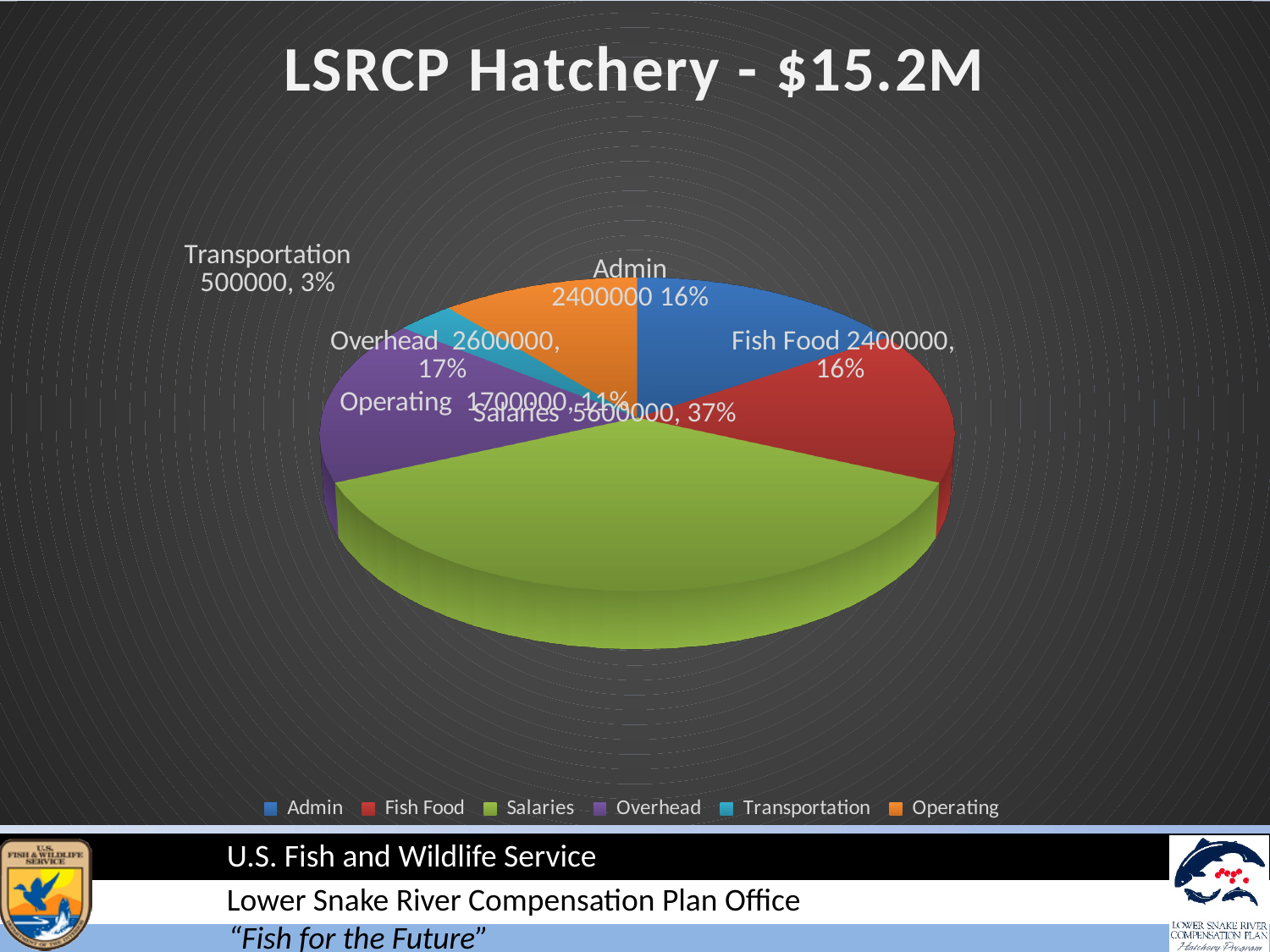
What is the value shown for Transportation? 500000 What percentage share of the pie is Overhead? 17% What percentage share of the pie is Operating? 11% What is the title of the chart? LSRCP Hatchery - $15.2M What is the value shown for Salaries? 5600000 Which category has the largest slice of the pie? Salaries How many entries does the legend list? 6 Which is larger, the value for Overhead or the value for Admin? Overhead How many slices does the pie chart have? 6 What kind of chart is shown on the slide? pie chart What is the difference between the Overhead value and the Operating value? 900000 Which category has the smallest slice of the pie? Transportation